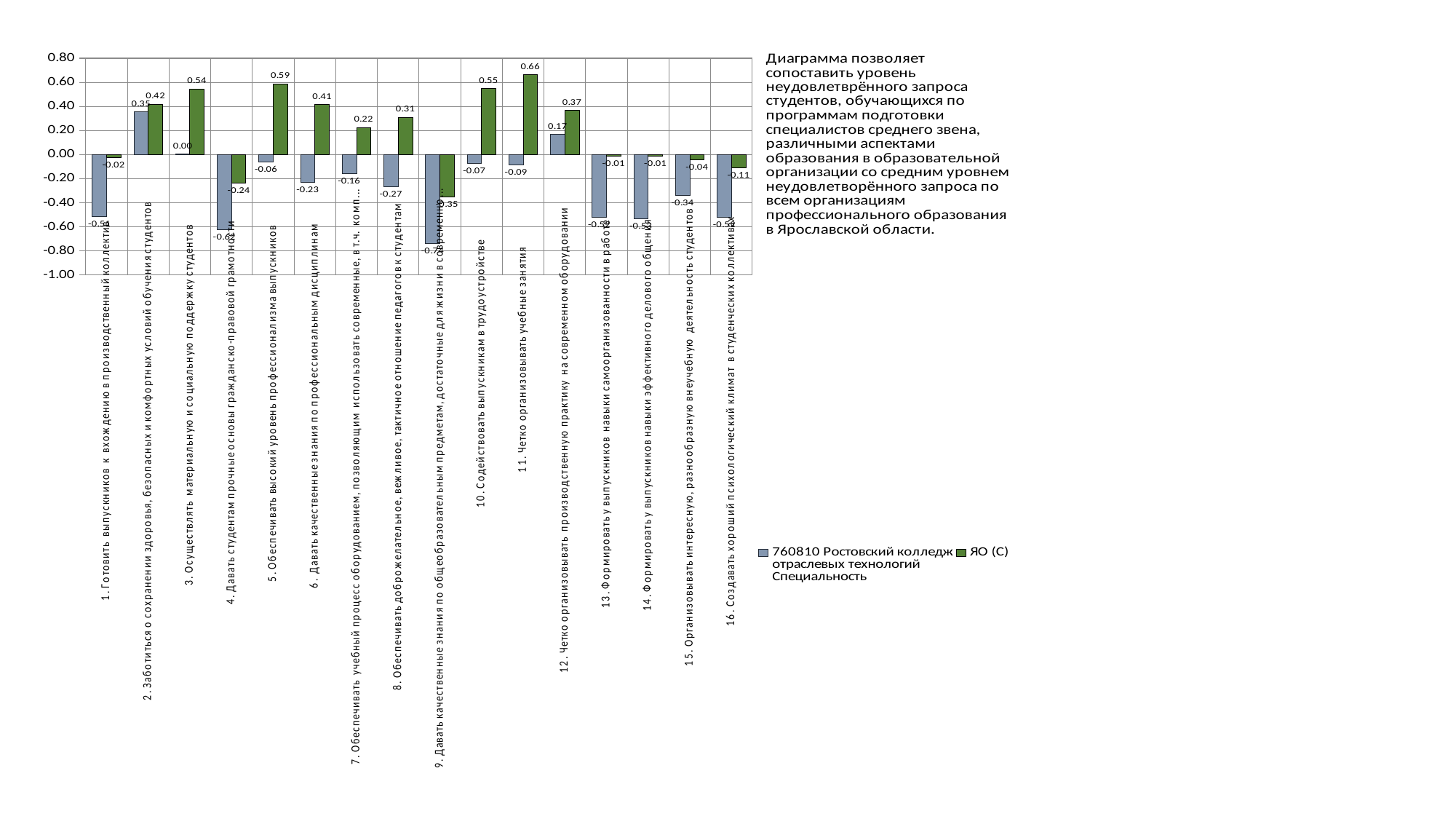
How many series does the legend list? 2 For category 6 (Давать качественные знания по профессиональным дисциплинам), which series has the larger value? ЯО (С) For which category is the ЯО (С) value the lowest? 9. Давать качественные знания по общеобразовательным предметам How many categories are plotted along the x axis? 16 What kind of chart is shown on the slide? bar chart What is the value of ЯО (С) for category 11 (Четко организовывать учебные занятия)? 0.66 Which series is drawn in green? ЯО (С) What is the value of 760810 Ростовский колледж отраслевых технологий for category 2 (Заботиться о сохранении здоровья)? 0.35 What is the value of ЯО (С) for category 5 (Обеспечивать высокий уровень профессионализма выпускников)? 0.59 For category 12 (Четко организовывать производственную практику), what is the difference between the ЯО (С) value and the Ростовский колледж value? 0.20 Is the value for 760810 Ростовский колледж отраслевых технологий in category 9 greater or less than -0.60? less For which category is the ЯО (С) value the highest? 11. Четко организовывать учебные занятия